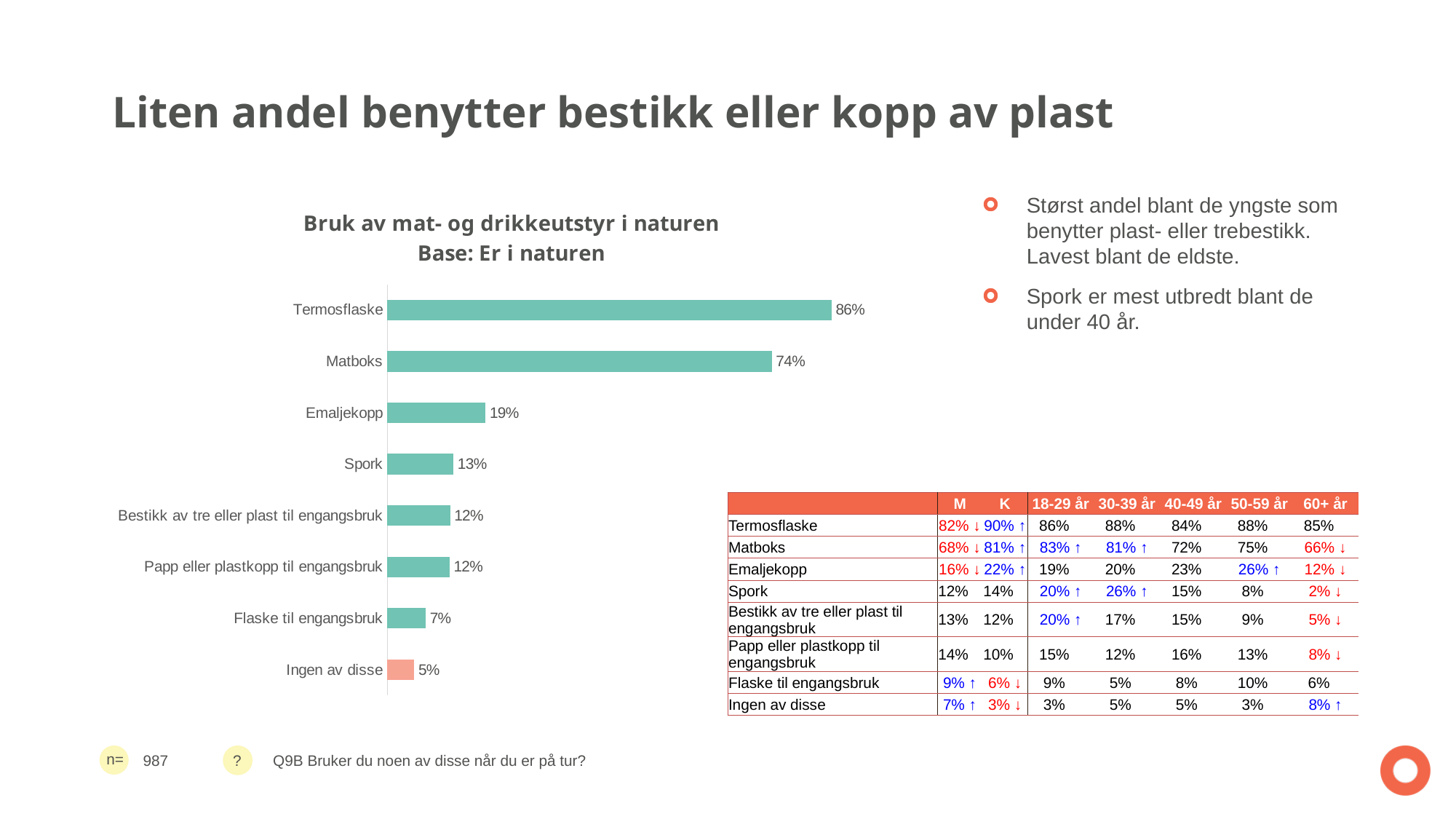
What is the value for Flaske til engangsbruk? 7% What is the difference between the values for Termosflaske and Matboks? 12% What is the title of the chart? Bruk av mat- og drikkeutstyr i naturen Base: Er i naturen Which category has the highest value? Termosflaske How many categories are shown in the chart? 8 Which category has the lowest value? Ingen av disse What is the difference between the values for Emaljekopp and Spork? 6% What is the value for Termosflaske? 86% What is the value for Emaljekopp? 19% Which bar is shown in a different colour from the others? Ingen av disse Which is larger, the value for Spork or the value for Flaske til engangsbruk? Spork What kind of chart is shown? Bar chart